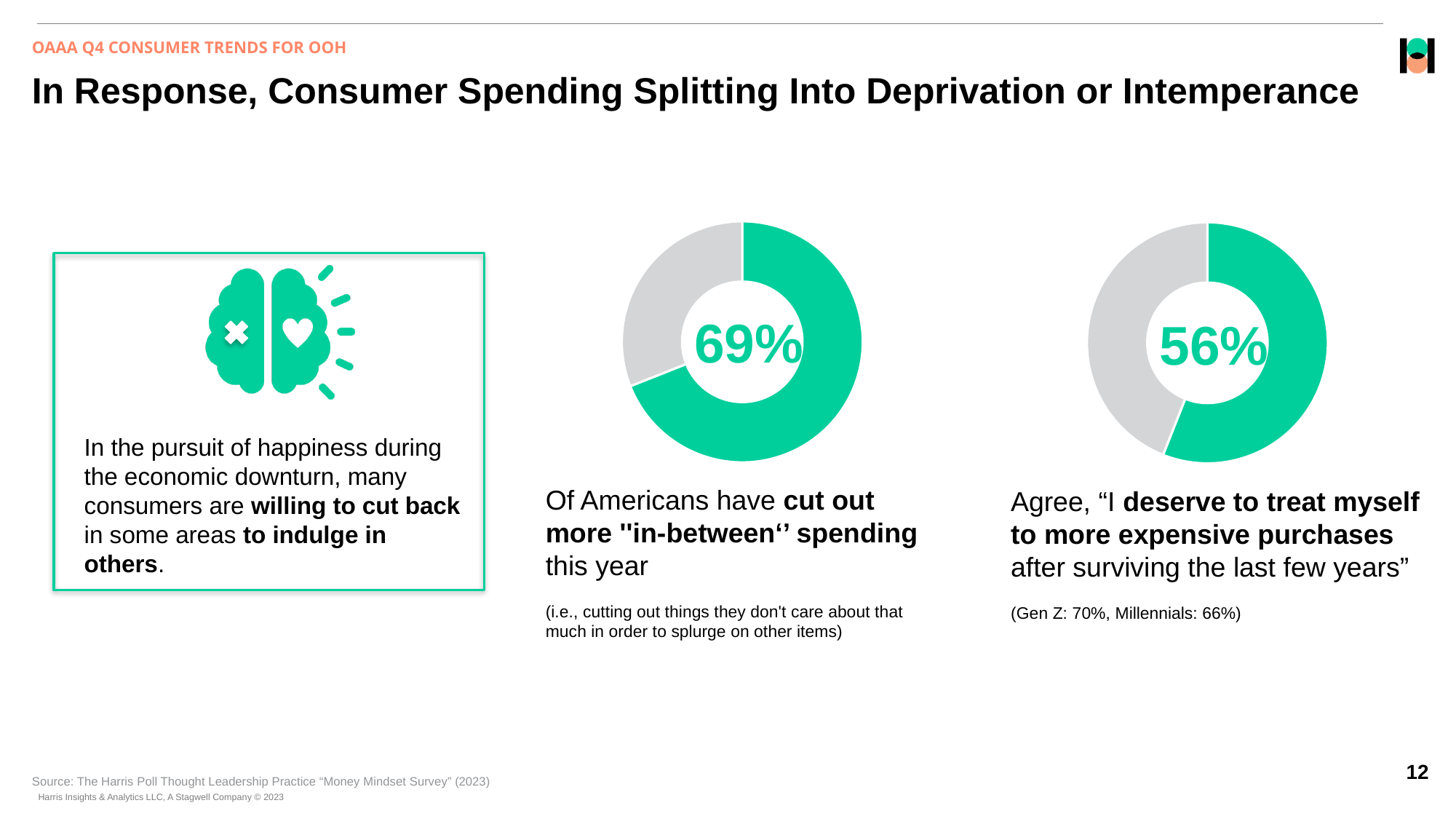
Is the value shown on the right-hand donut chart greater or less than 50%? greater On the right-hand donut chart, what share of the ring is the grey (remaining) portion? 44% How many segments does the right-hand donut chart have? 2 On the middle donut chart, what share of the ring is the grey (remaining) portion? 31% What colour is used for the highlighted (filled) segment in both donut charts? Green How many donut charts are shown on the slide? 2 On the middle donut chart, what percentage of Americans have cut out more "in-between" spending this year? 69% Is the value shown on the middle donut chart greater or less than 70%? less What kind of chart is used to show the 69% figure in the middle of the slide? Donut (pie) chart On the right-hand donut chart, what percentage agree "I deserve to treat myself to more expensive purchases after surviving the last few years"? 56% Which is larger: the share of Americans who cut out more "in-between" spending (middle chart) or the share who agree they deserve to treat themselves (right chart)? Cut out more "in-between" spending (69%) What is the difference in percentage points between the middle donut chart (69%) and the right-hand donut chart (56%)? 13 percentage points